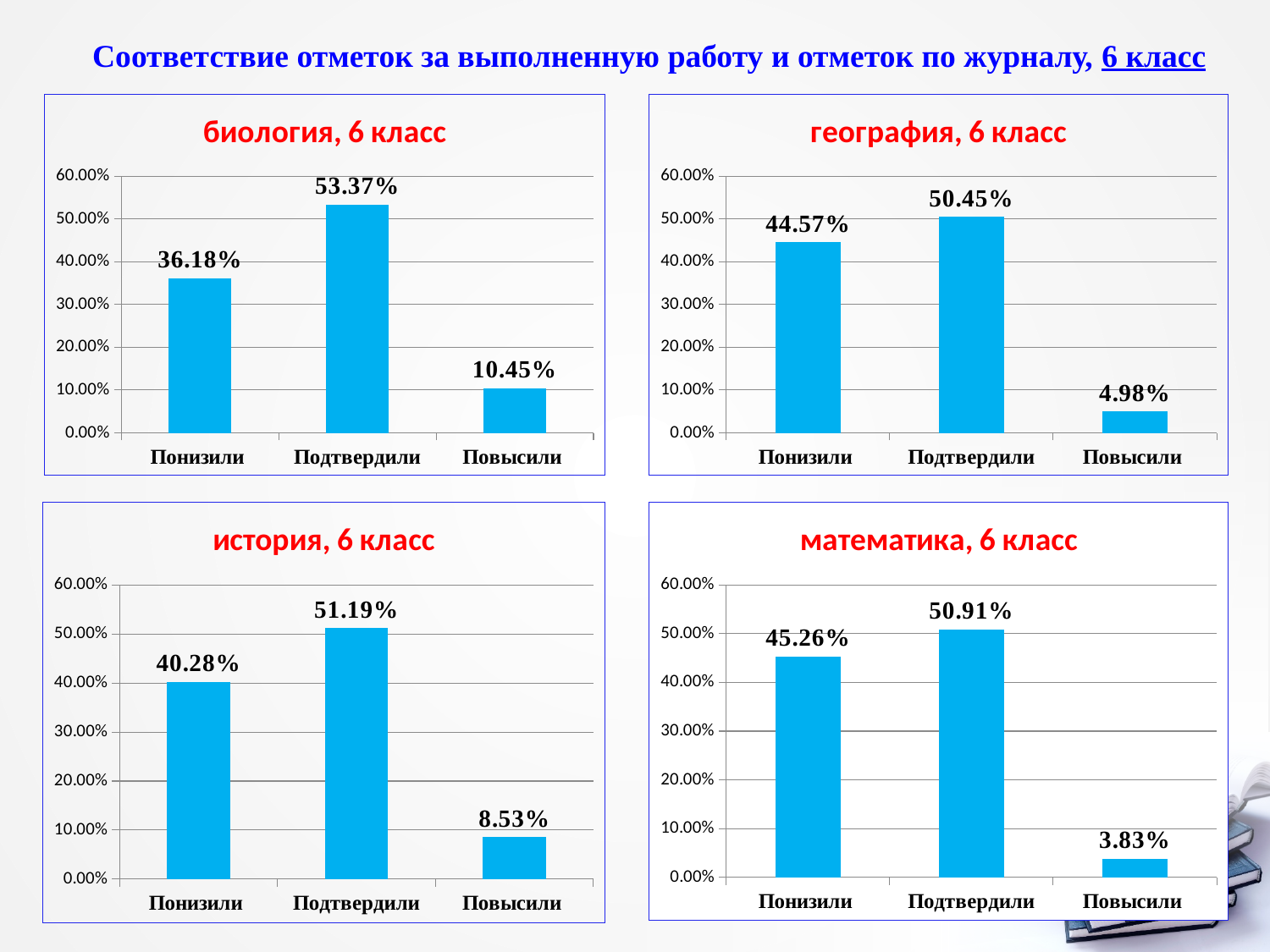
In the chart titled "биология, 6 класс", what is the value for Подтвердили? 53.37% In the chart titled "математика, 6 класс", which category has the highest value? Подтвердили In the chart titled "история, 6 класс", what is the value for Понизили? 40.28% In the chart titled "география, 6 класс", what is the value for Повысили? 4.98% In the chart titled "биология, 6 класс", which category has the lowest value? Повысили How many categories are shown in the chart titled "биология, 6 класс"? 3 In the chart titled "математика, 6 класс", is the value for Повысили greater or less than 10.00%? less In the chart titled "география, 6 класс", what is the difference between the values for Подтвердили and Понизили? 5.88% In the chart titled "математика, 6 класс", what is the value for Понизили? 45.26% What kind of chart is the chart titled "география, 6 класс"? bar chart In the chart titled "история, 6 класс", which is larger: the value for Понизили or the value for Повысили? Понизили How many charts are shown on the slide? 4